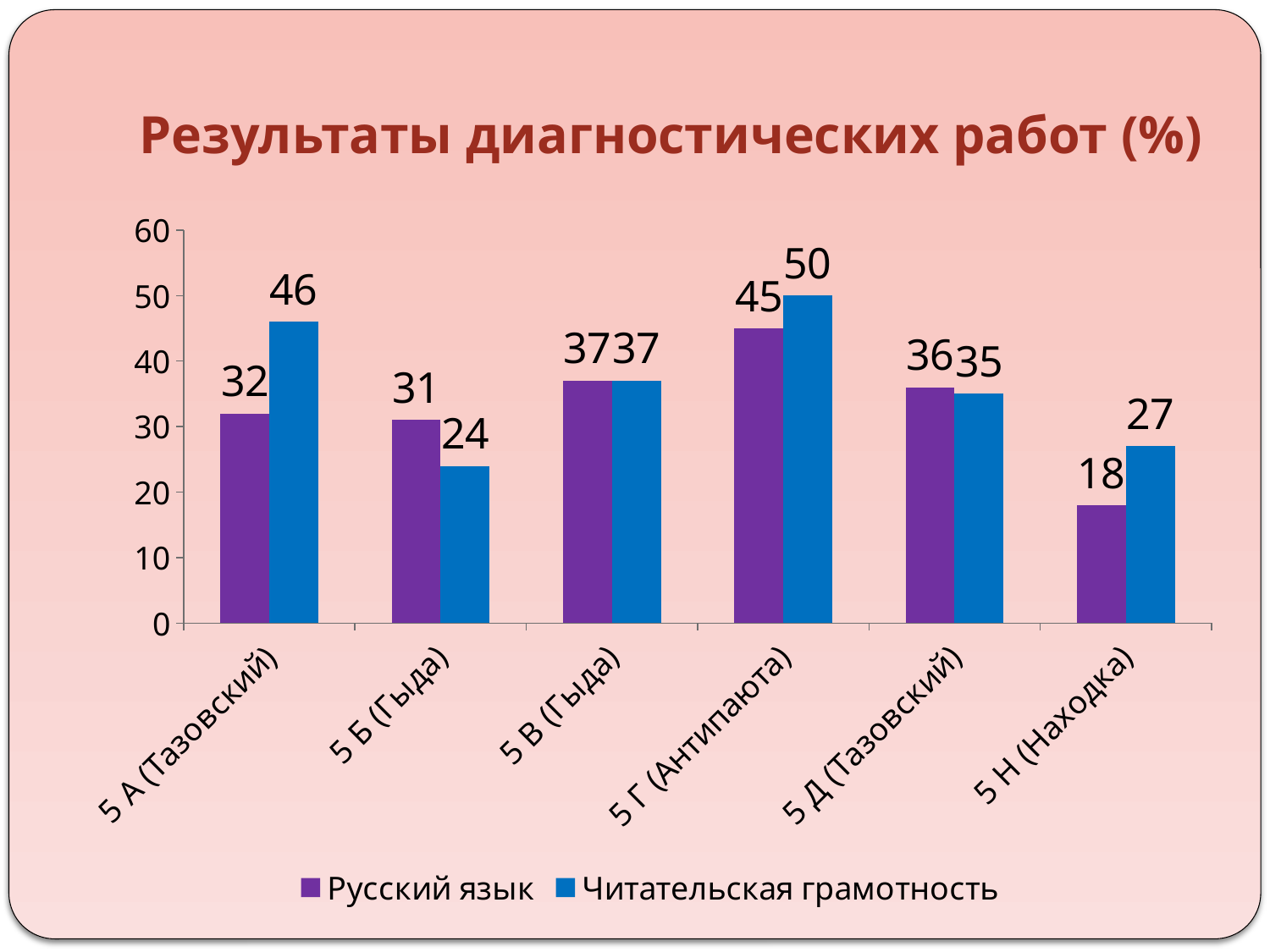
What kind of chart is shown on the slide? Bar chart What colour are the bars for Читательская грамотность? Blue How many categories are shown on the x axis? 6 Which is larger for 5 Б (Гыда): Русский язык or Читательская грамотность? Русский язык What is the value for Русский язык for 5 А (Тазовский)? 32 What is the difference between the Читательская грамотность and Русский язык values for 5 А (Тазовский)? 14 What is the title of the chart? Результаты диагностических работ (%) Which category has the highest value for Читательская грамотность? 5 Г (Антипаюта) What is the value for Читательская грамотность for 5 Н (Находка)? 27 How many series does the legend list? 2 Which category has the lowest value for Русский язык? 5 Н (Находка) What is the value for Читательская грамотность for 5 Б (Гыда)? 24